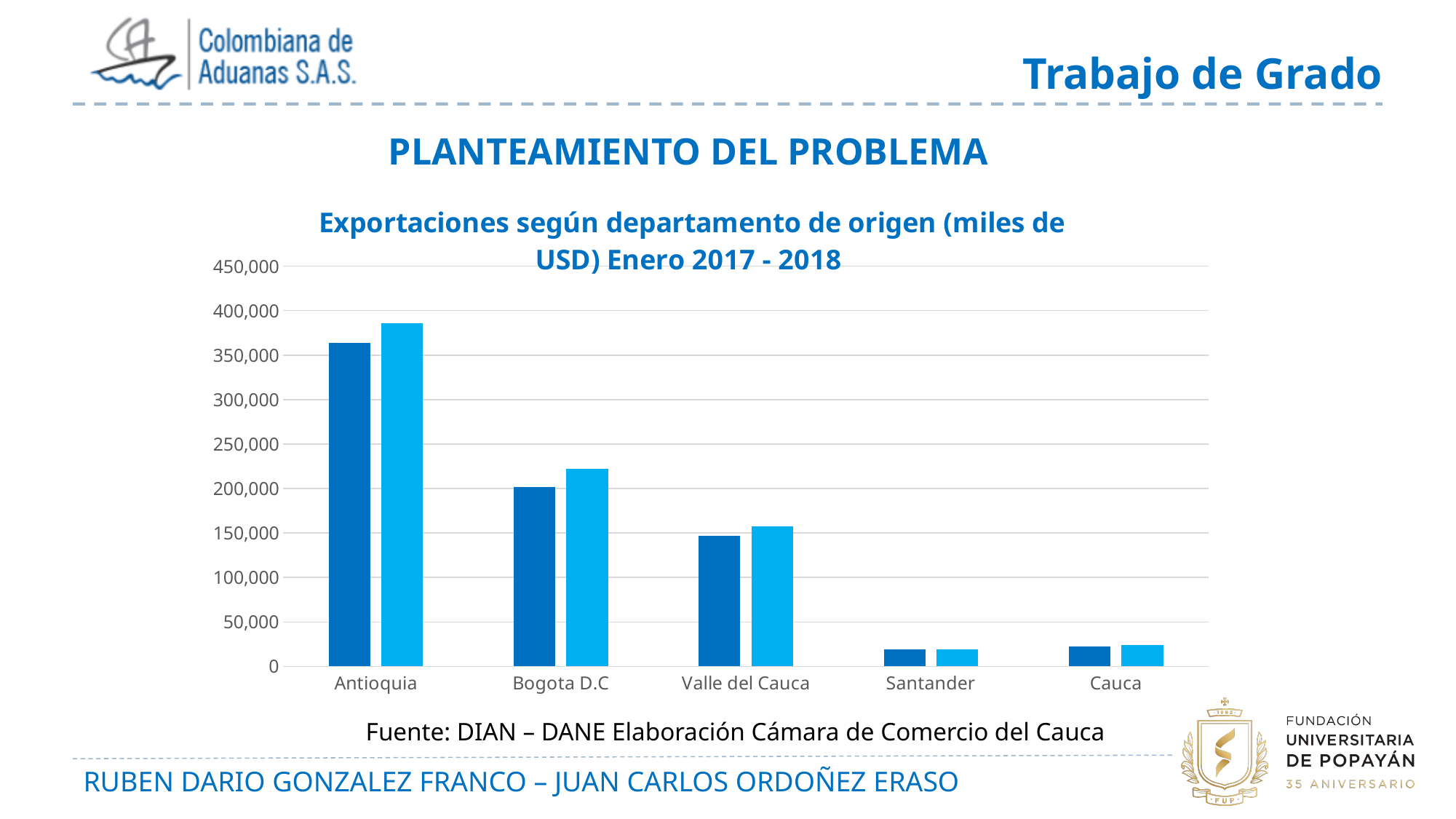
What source is cited below the chart? DIAN – DANE Elaboración Cámara de Comercio del Cauca Which department has higher export values, Bogota D.C or Valle del Cauca? Bogota D.C How many departments (categories) are shown on the x axis of the chart? 5 Which department has the highest export values in the chart? Antioquia Is the value of the light blue bar for Bogota D.C greater or less than 200,000? greater Is the value of the light blue bar for Antioquia greater or less than 400,000? less Is the value of the light blue bar for Antioquia greater or less than 350,000? greater What kind of chart is shown on the slide? Bar chart What is the title of the chart? Exportaciones según departamento de origen (miles de USD) Enero 2017 - 2018 Do the export values generally rise or fall moving from Antioquia on the left to Cauca on the right? Fall Which department has the lowest export values in the chart? Santander